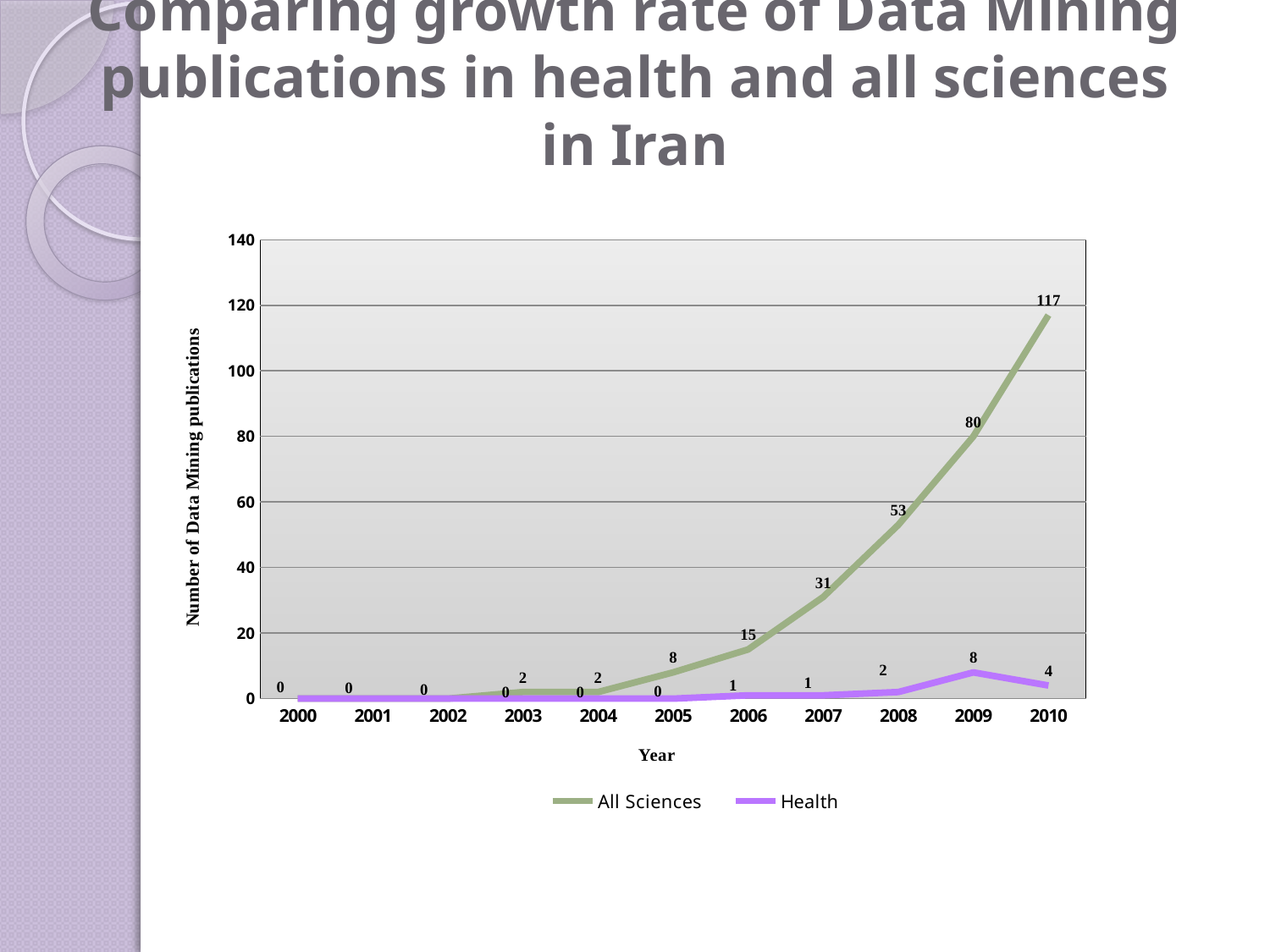
Does the All Sciences series rise or fall from 2005 to 2010? Rise What is the value for Health in 2010? 4 In which year is the All Sciences value highest? 2010 Which series has the larger value in 2008, All Sciences or Health? All Sciences What is the value for All Sciences in 2007? 31 How many years are shown on the x axis? 11 What is the value for All Sciences in 2010? 117 How many series does the legend list? 2 What kind of chart is shown on the slide? Line chart In which year is the Health value highest? 2009 What is the value for Health in 2009? 8 What is the difference between the All Sciences values for 2010 and 2009? 37